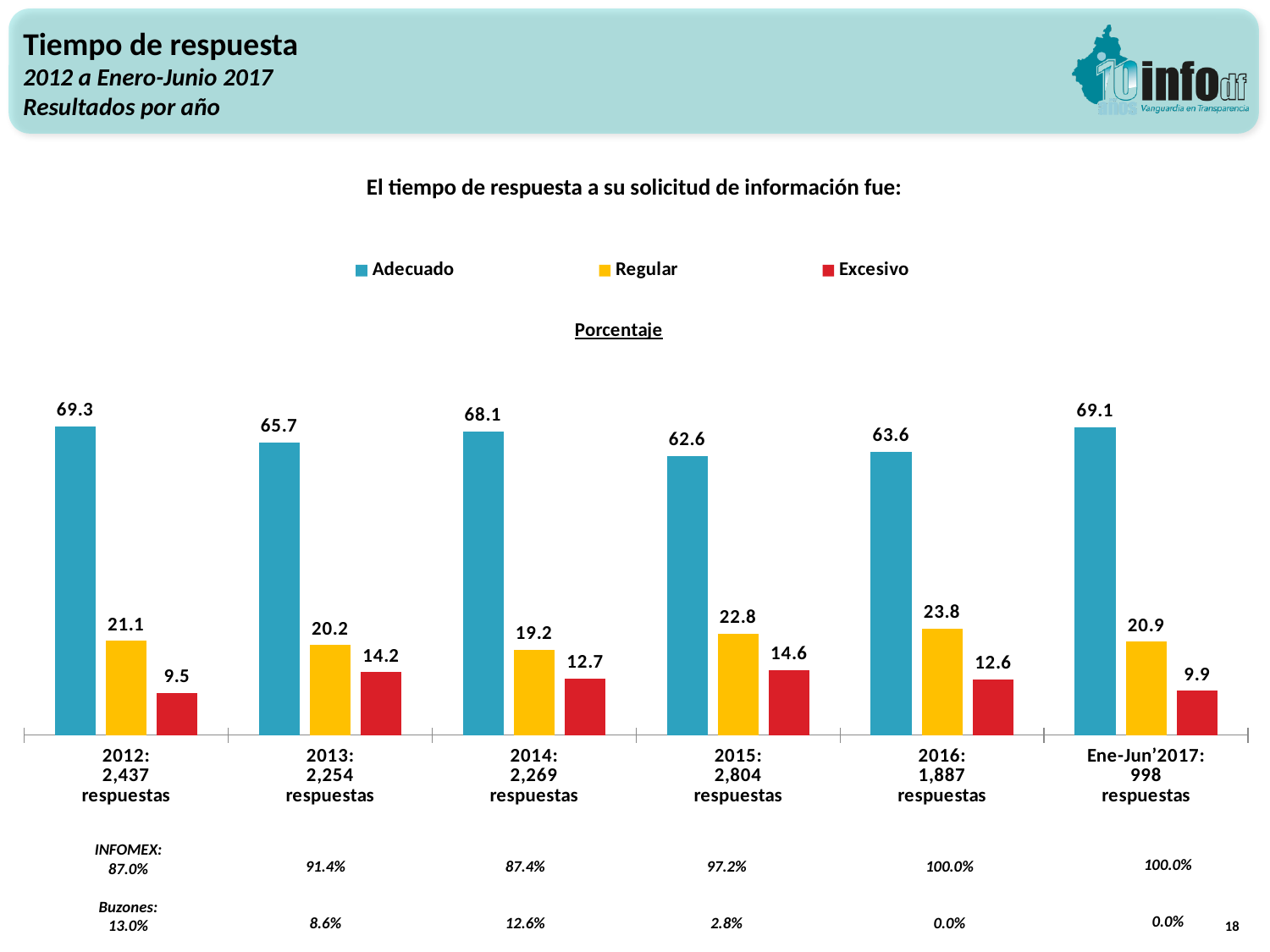
How many series does the legend list? 3 How many year categories are shown on the x axis? 6 Which year has the highest Excesivo value? 2015 What is the Adecuado value for 2012? 69.3 What is the Excesivo value for 2014? 12.7 What kind of chart is shown on the slide? Bar chart Is the Regular value for 2015 larger than the Regular value for 2014? Yes What is the Adecuado value for Ene-Jun'2017? 69.1 Which year has the lowest Adecuado value? 2015 What is the Regular value for 2016? 23.8 What is the difference between the Adecuado and Regular values for 2013? 45.5 Which colour represents the Excesivo series in the legend? Red